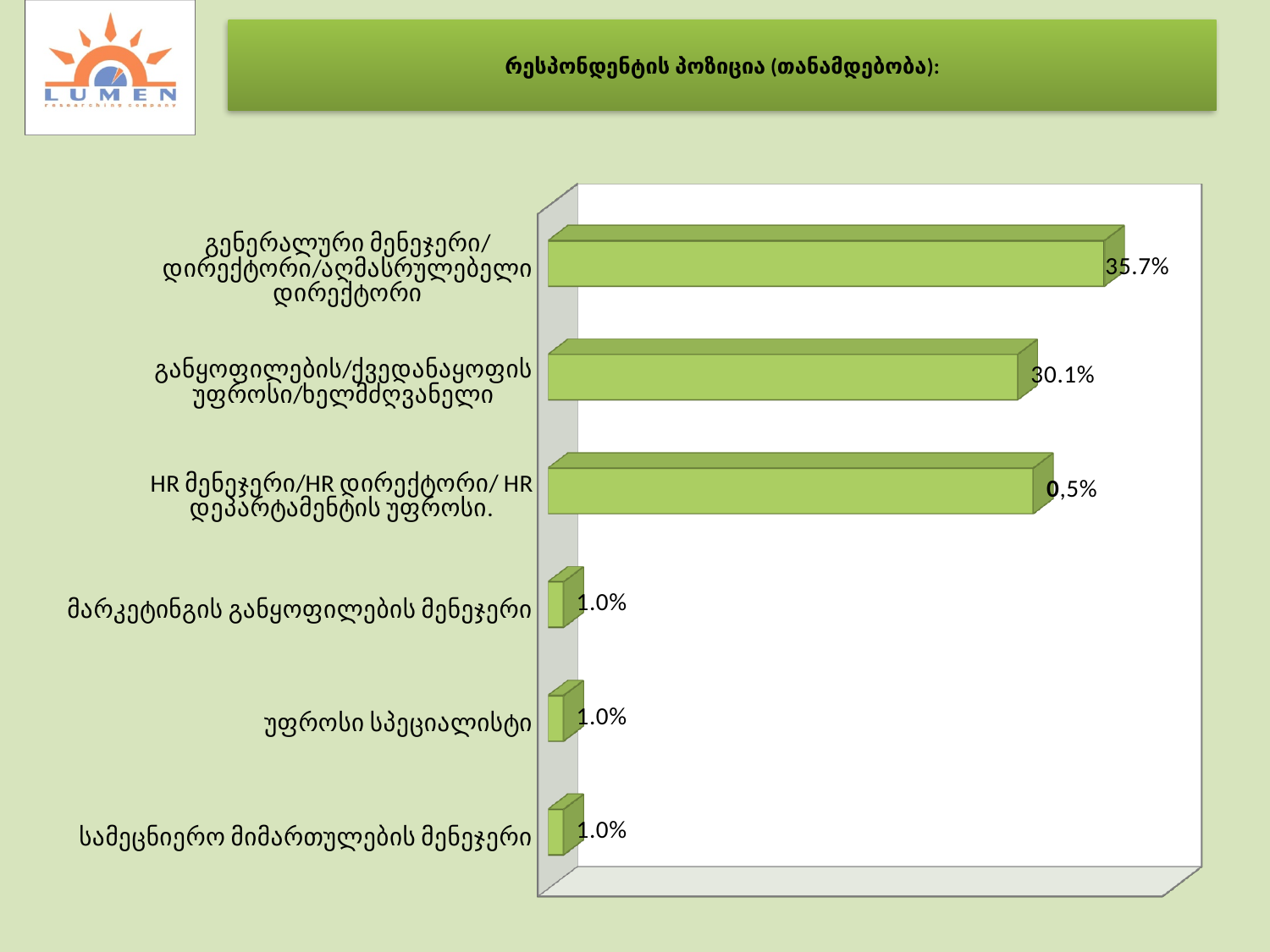
What is the value for მარკეტინგის განყოფილების მენეჯერი? 1.0% How many categories are shown in the chart? 6 What kind of chart is shown on the slide? bar chart What is the difference between the values for გენერალური მენეჯერი/დირექტორი/აღმასრულებელი დირექტორი and განყოფილების/ქვედანაყოფის უფროსი/ხელმძღვანელი? 5.6 percentage points What is the value for განყოფილების/ქვედანაყოფის უფროსი/ხელმძღვანელი? 30.1% What is the title of the chart? რესპონდენტის პოზიცია (თანამდებობა): What is the lowest value shown in the chart? 1.0% What is the value for გენერალური მენეჯერი/დირექტორი/აღმასრულებელი დირექტორი? 35.7% Which is larger, the value for განყოფილების/ქვედანაყოფის უფროსი/ხელმძღვანელი or the value for უფროსი სპეციალისტი? განყოფილების/ქვედანაყოფის უფროსი/ხელმძღვანელი What is the value for სამეცნიერო მიმართულების მენეჯერი? 1.0% What is the value for უფროსი სპეციალისტი? 1.0% Which category has the highest value? გენერალური მენეჯერი/დირექტორი/აღმასრულებელი დირექტორი